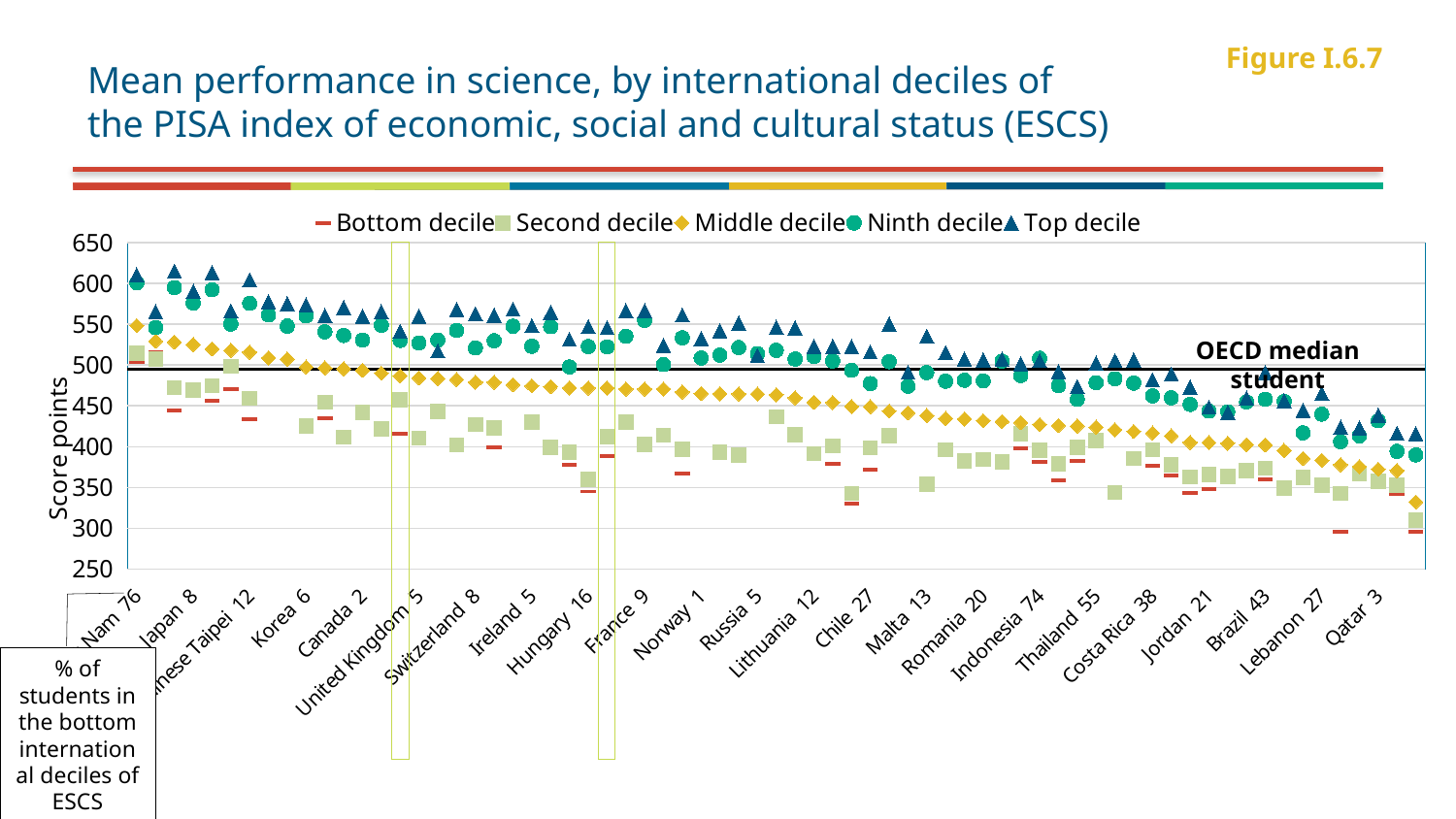
Do the Top decile values generally rise or fall from left to right along the x axis? fall Is the Top decile value for Korea greater or less than 550? greater What does the horizontal black line across the chart represent? OECD median student Is the Middle decile value for Qatar greater or less than 350? greater What kind of chart is shown on the slide? scatter (dot) chart How many series does the legend list? 5 Is the Bottom decile value for Chile greater or less than 350? greater Which series does the legend list first? Bottom decile